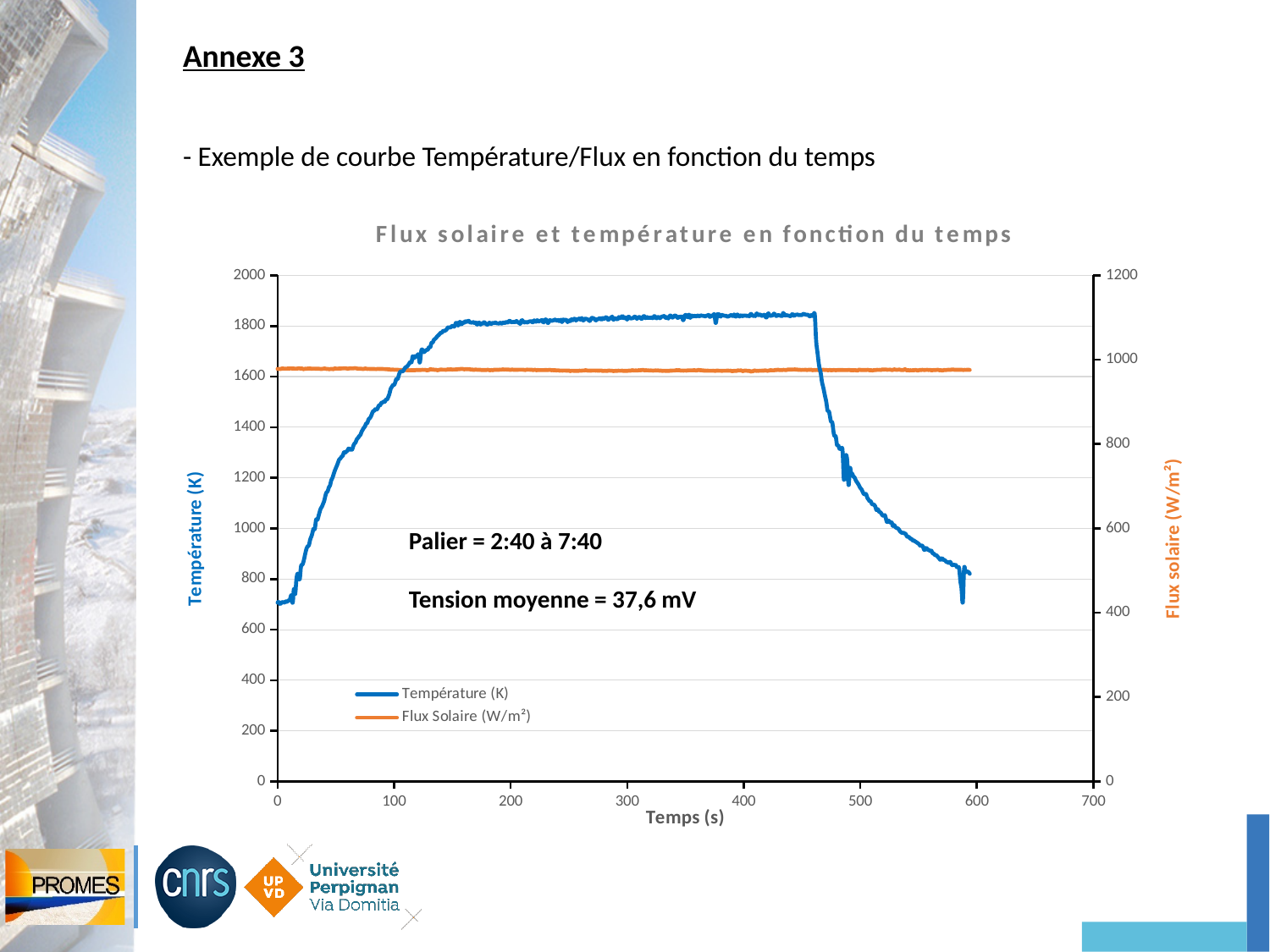
How many series does the legend list? 2 Does the Température (K) series rise or fall between 470 s and 590 s? fall What is the title of the chart? Flux solaire et température en fonction du temps Is the value of Température (K) at 400 s greater or less than 1600? greater What is the label of the x axis? Temps (s) Is the value of Flux Solaire (W/m²) at 300 s greater or less than 800 on the right axis? greater Does the Température (K) series rise or fall between 0 s and 150 s? rise Is the value of Température (K) at 550 s greater or less than 1200? less What kind of chart is shown on the slide? line chart